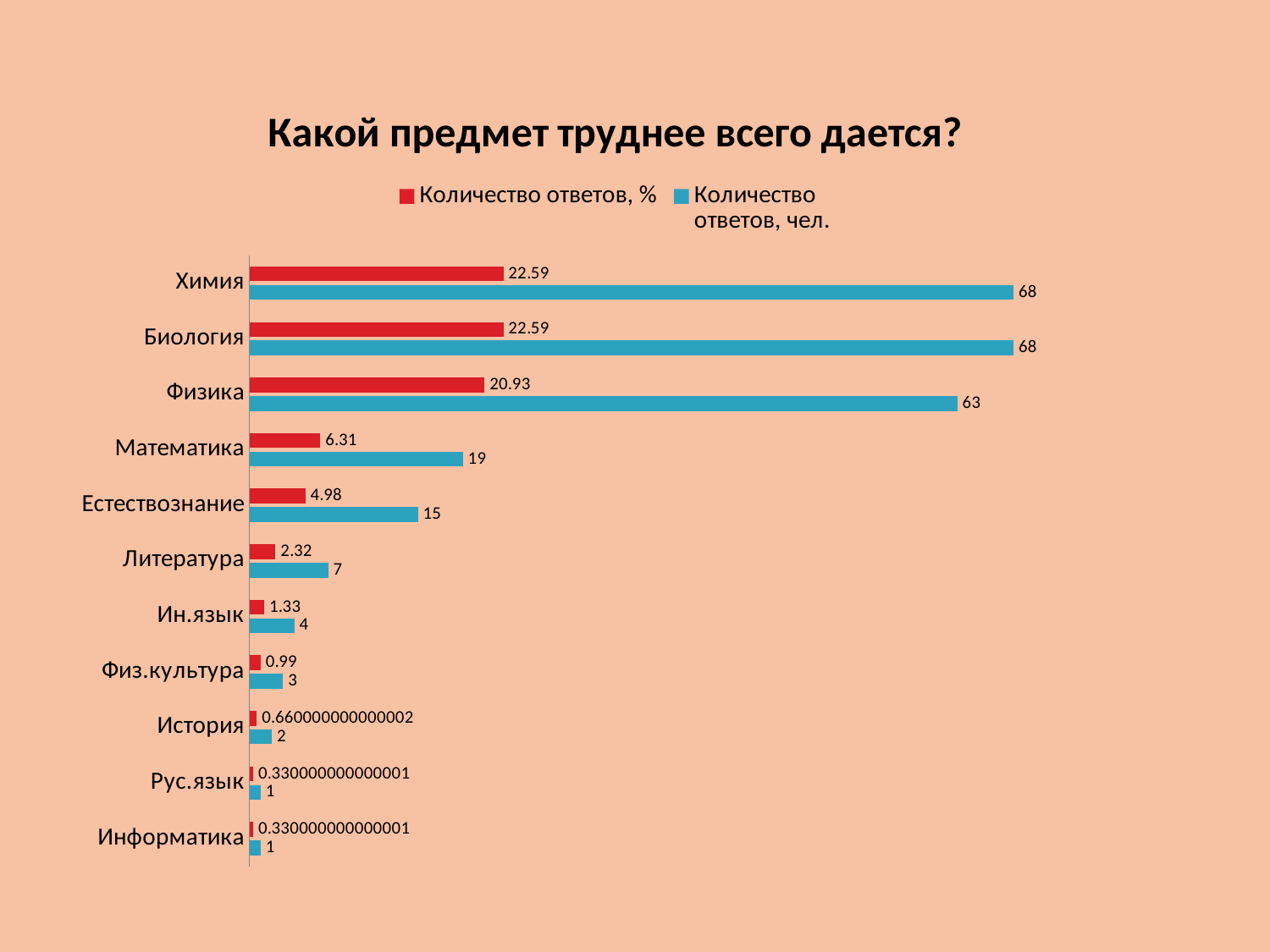
What is the value of 'Количество ответов, %' for Литература? 2.32 What is the title of the chart? Какой предмет труднее всего дается? Which colour represents the series 'Количество ответов, чел.'? blue How many series does the legend list? 2 Which has a larger value of 'Количество ответов, чел.': Математика or Естествознание? Математика What is the value of 'Количество ответов, чел.' for Естествознание? 15 What is the value of 'Количество ответов, %' for Математика? 6.31 What is the difference in 'Количество ответов, чел.' between Химия and Физика? 5 What kind of chart is shown on the slide? bar chart What is the value of 'Количество ответов, чел.' for Физика? 63 What is the difference in 'Количество ответов, %' between Физика and Математика? 14.62 How many subjects (categories) are shown on the chart? 11